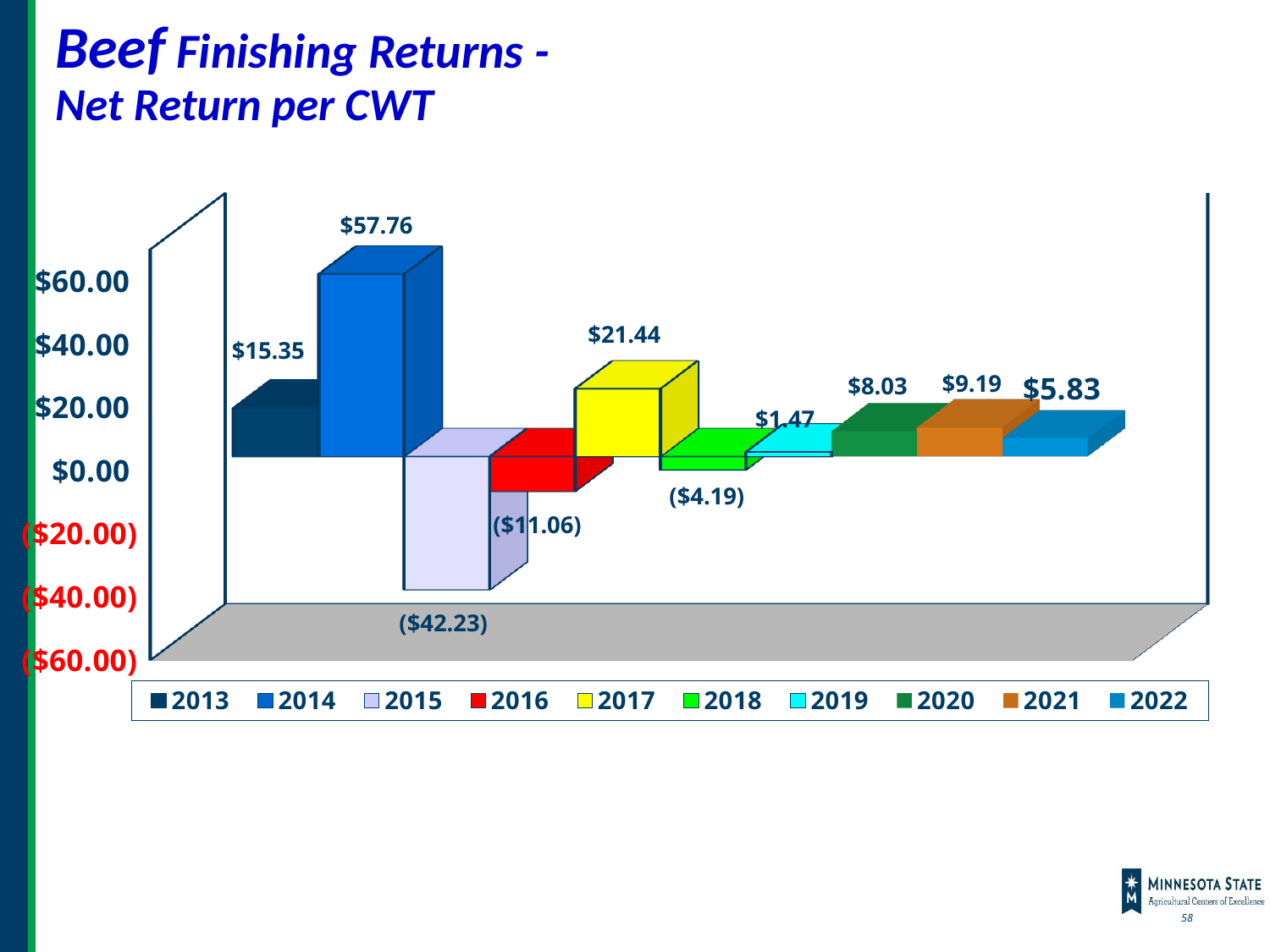
What is the title of the chart on the slide? Beef Finishing Returns - Net Return per CWT What kind of chart is shown on the slide? Bar chart Which year has the lowest net return per CWT? 2015 What is the net return per CWT for 2017? $21.44 What is the difference between the net return per CWT in 2014 and in 2013? $42.41 What is the net return per CWT for 2022? $5.83 Which year has the highest net return per CWT? 2014 Which year has a larger net return per CWT, 2020 or 2021? 2021 How many years are shown in the chart? 10 What is the net return per CWT for 2014? $57.76 What is the net return per CWT for 2015? ($42.23) Is the value for 2014 greater or less than $40.00? greater